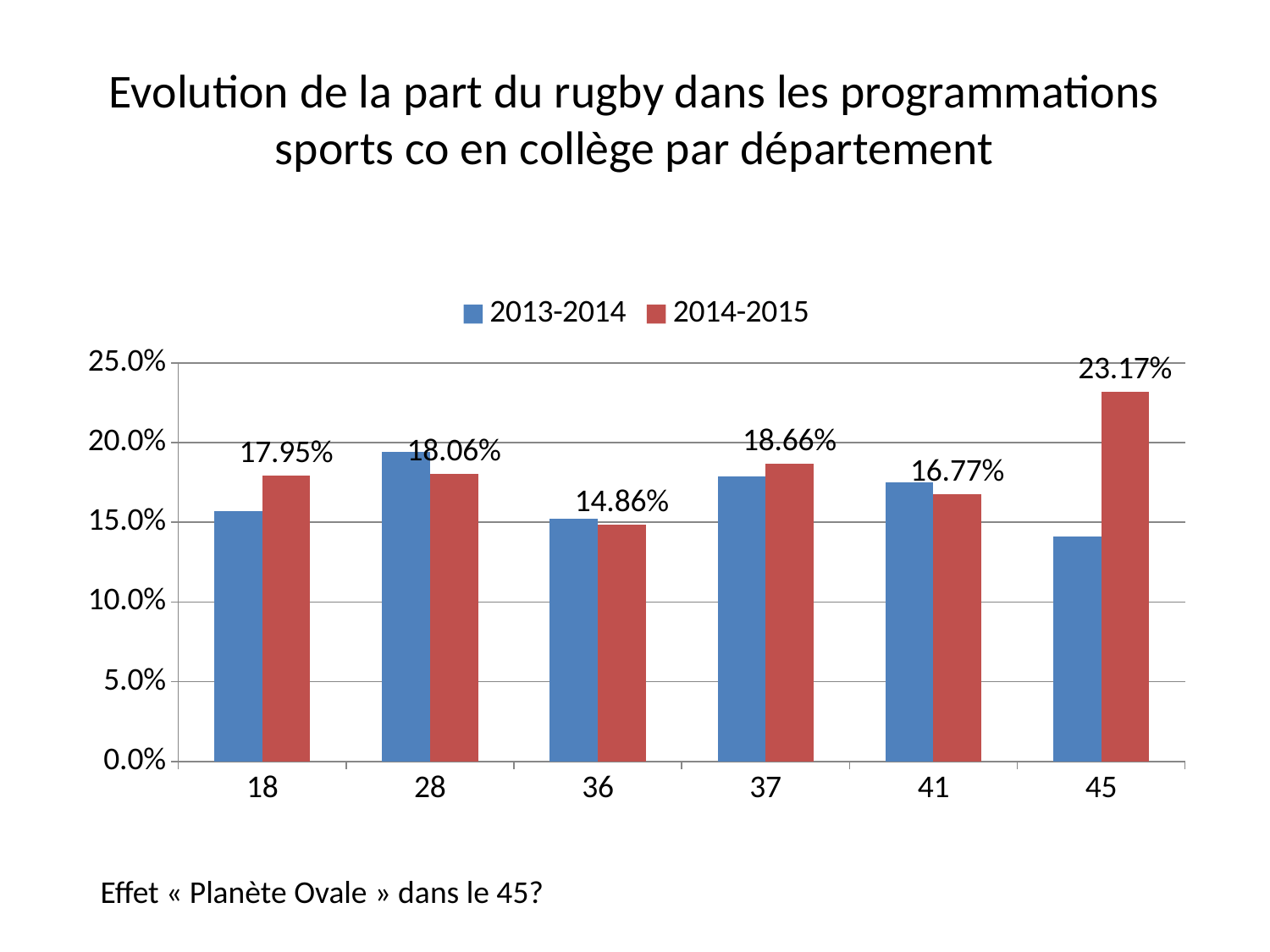
Which department has the lowest value in the 2014-2015 series? 36 What is the value for department 36 in the 2014-2015 series? 14.86% Which department has the highest value in the 2014-2015 series? 45 What is the difference between the 2014-2015 values for department 45 and department 18? 5.22% Is the 2013-2014 value for department 45 greater or less than 15.0%? less For department 45, which series has the larger value, 2013-2014 or 2014-2015? 2014-2015 In the 2014-2015 series, which department has the larger value, 28 or 37? 37 How many series does the legend list? 2 What kind of chart is shown on the slide? bar chart How many departments are shown on the x axis? 6 What is the value for department 45 in the 2014-2015 series? 23.17% What is the value for department 41 in the 2014-2015 series? 16.77%